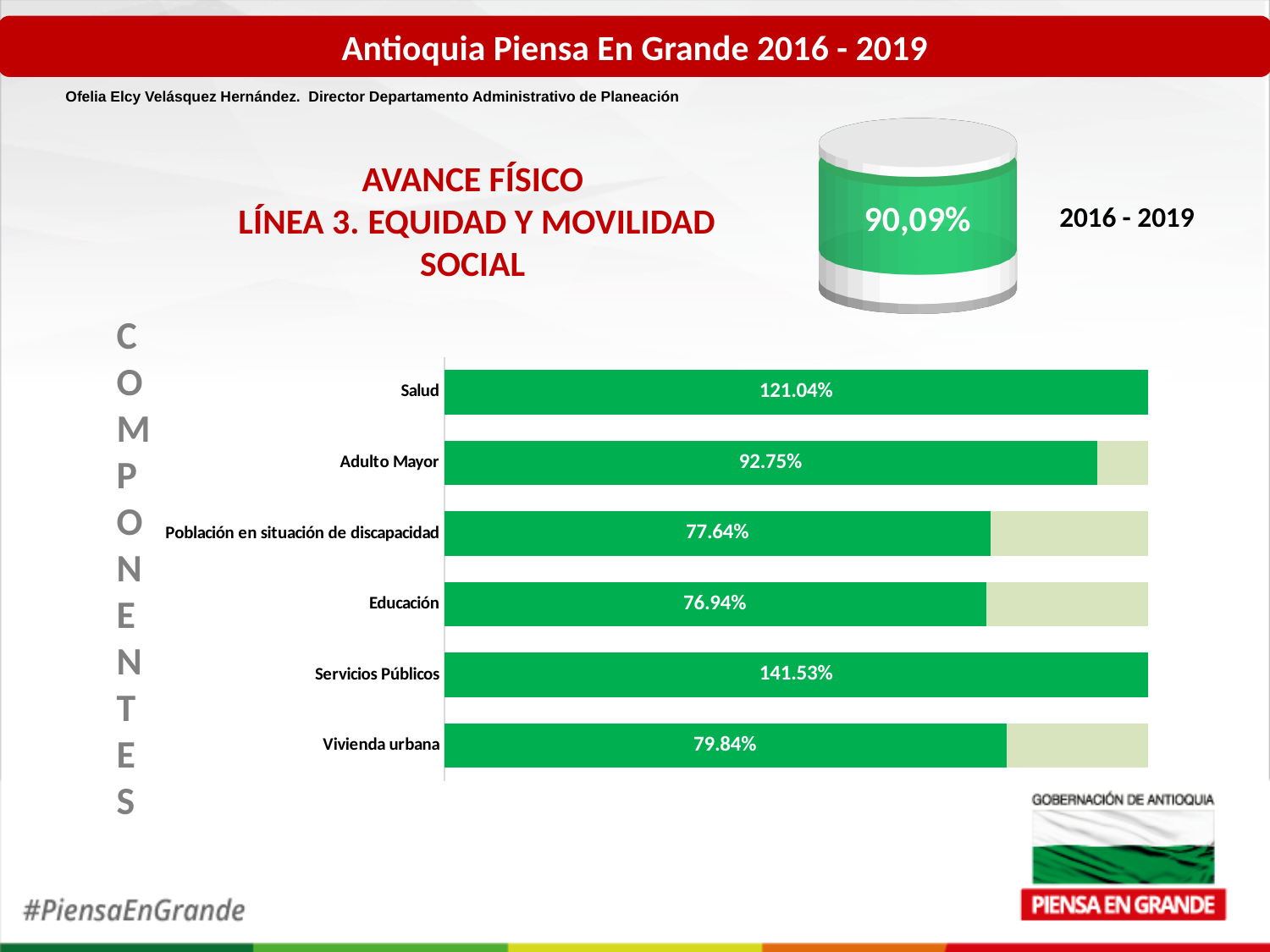
What is the value for Vivienda urbana? 79.84% What is the value for Educación? 76.94% What is the difference between the values for Servicios Públicos and Salud? 20.49% Which is larger, the value for Adulto Mayor or the value for Vivienda urbana? Adulto Mayor What is the value for Población en situación de discapacidad? 77.64% How many components are shown in the chart? 6 Which component has the highest value? Servicios Públicos What kind of chart is shown on the slide? Bar chart What is the value for Servicios Públicos? 141.53% What is the value for Salud? 121.04% What is the value for Adulto Mayor? 92.75% Which component has the lowest value? Educación